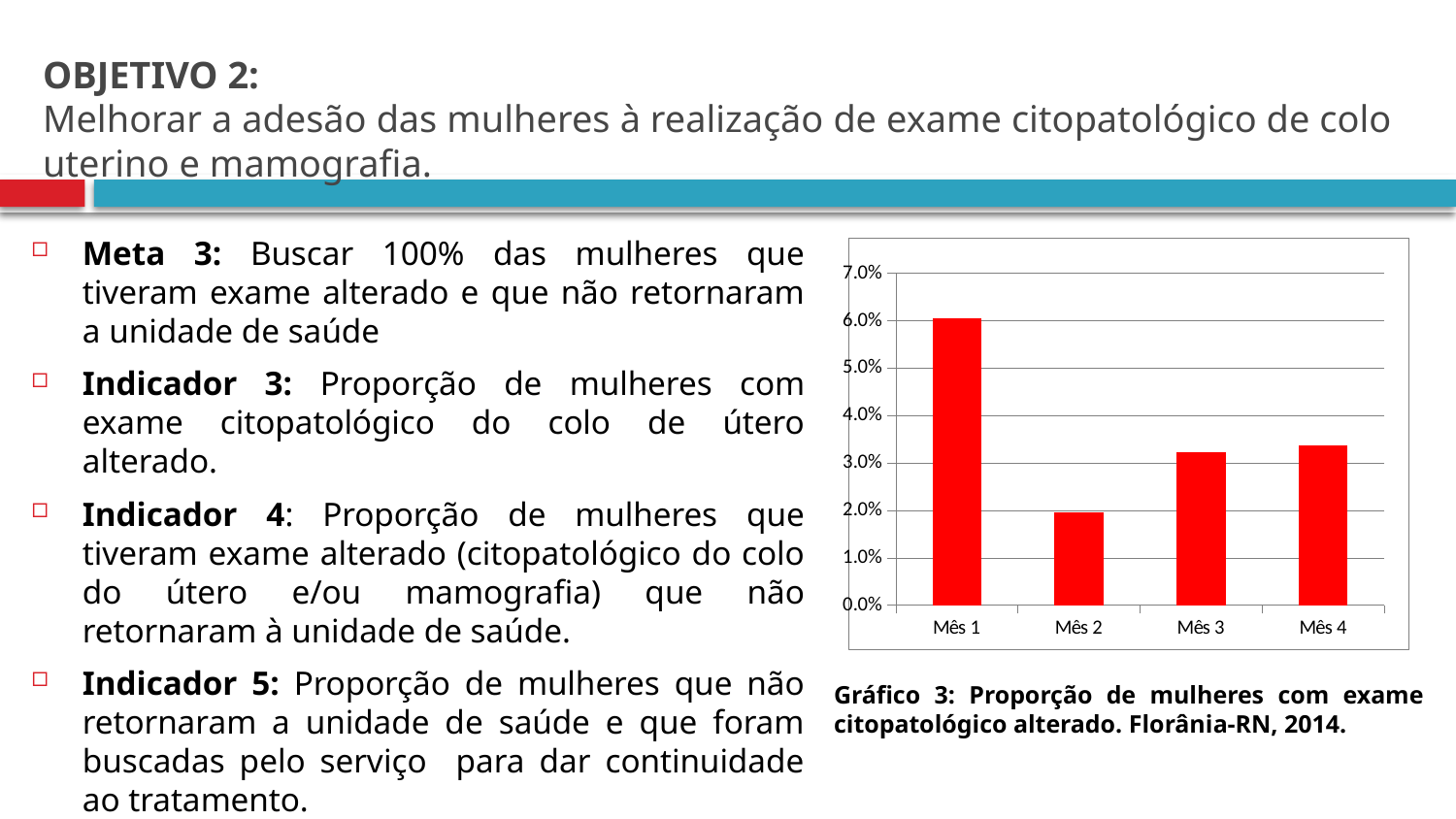
Which is larger, the value for Mês 2 or the value for Mês 3? Mês 3 How many categories (months) are shown on the x axis of the chart? 4 Is the value for Mês 3 greater or less than 2.0%? greater Which month has the highest value in the chart? Mês 1 Is the value for Mês 4 greater or less than 4.0%? less What is the highest tick value shown on the y axis of the chart? 7.0% Which month has the lowest value in the chart? Mês 2 Is the value for Mês 1 greater or less than 5.0%? greater Which is larger, the value for Mês 1 or the value for Mês 2? Mês 1 What colour are the bars in the chart? Red What kind of chart is shown on the slide? Bar chart